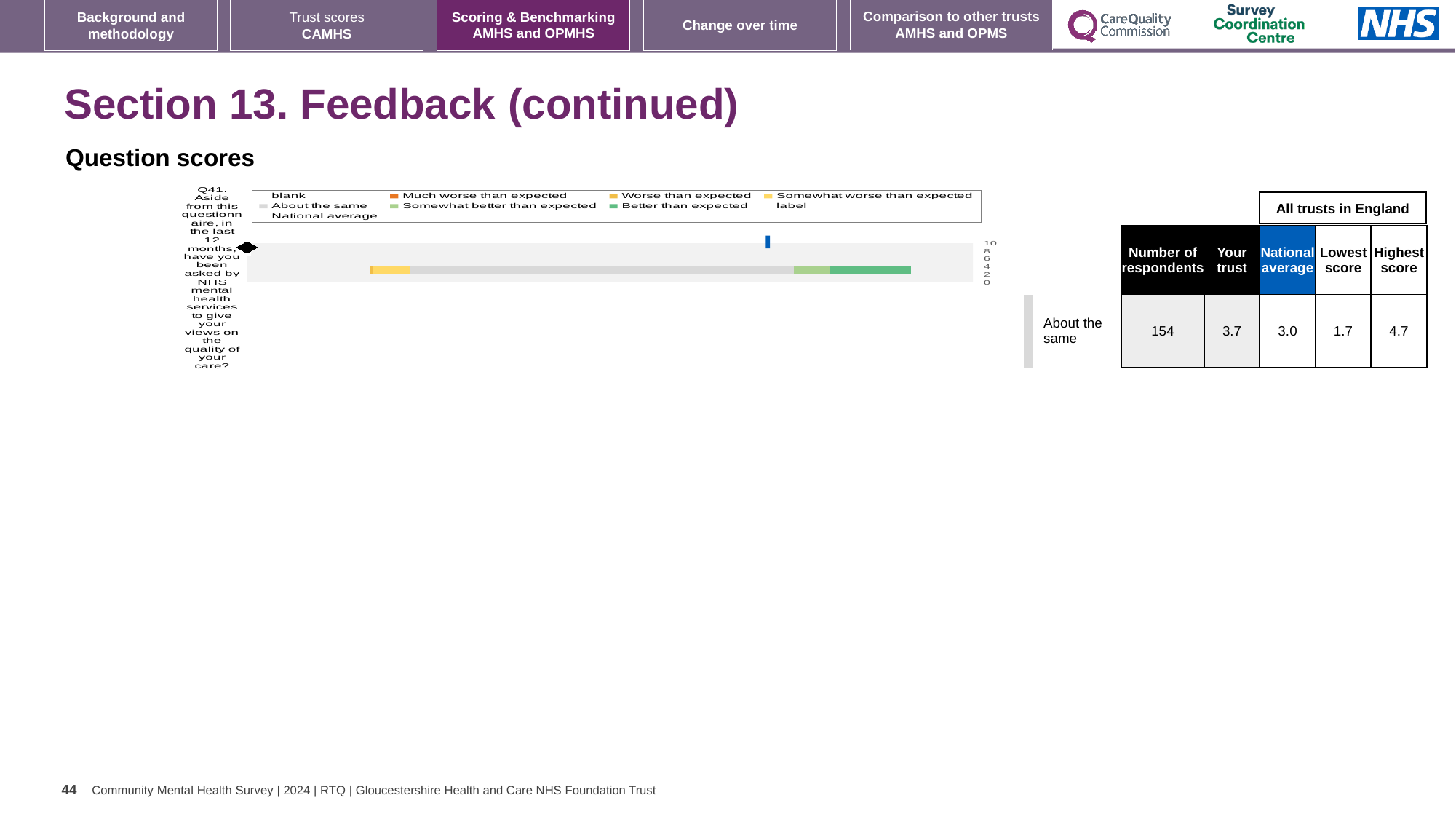
In the table beside the chart, what is the 'Your trust' score for Q41? 3.7 How many questions are plotted in the chart? 1 What is the highest value shown on the chart's axis? 10 In the table beside the chart, what is the national average score for Q41? 3.0 In the table beside the chart, what is the lowest score among all trusts in England for Q41? 1.7 What benchmark category is the trust's Q41 score placed in, according to the label next to the chart? About the same What is the difference between the highest score and the lowest score for Q41 in the table? 3.0 In the table beside the chart, what is the number of respondents for Q41? 154 In the table beside the chart, what is the highest score among all trusts in England for Q41? 4.7 Is the 'Your trust' score for Q41 higher or lower than the national average? higher What kind of chart is used to show the Q41 question score? bar chart Which question number is plotted in the chart? Q41